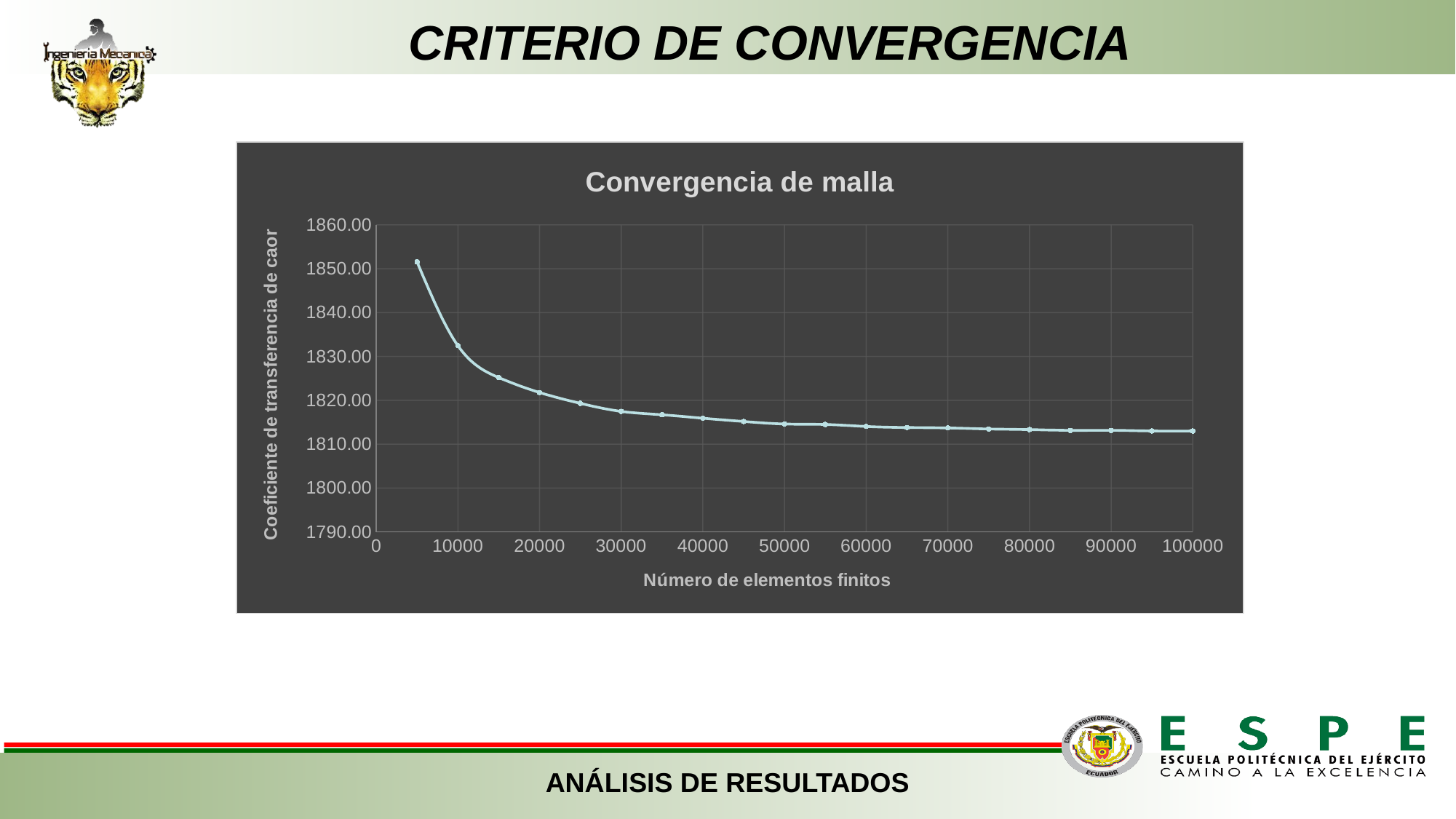
What is the title of the chart? Convergencia de malla Is the value at 50000 finite elements greater or less than 1820.00? less What kind of chart is shown on the slide? line chart Which has the larger coefficient value: 10000 or 30000 finite elements? 10000 Do the values rise or fall as the number of finite elements increases along the x axis? fall Is the value at 100000 finite elements greater or less than 1810.00? greater What is the label of the x axis of the chart? Número de elementos finitos Is the value at 5000 finite elements greater or less than 1840.00? greater At which number of finite elements is the coefficient highest? 5000 How many data points are plotted on the line? 20 Which has the larger coefficient value: 5000 or 100000 finite elements? 5000